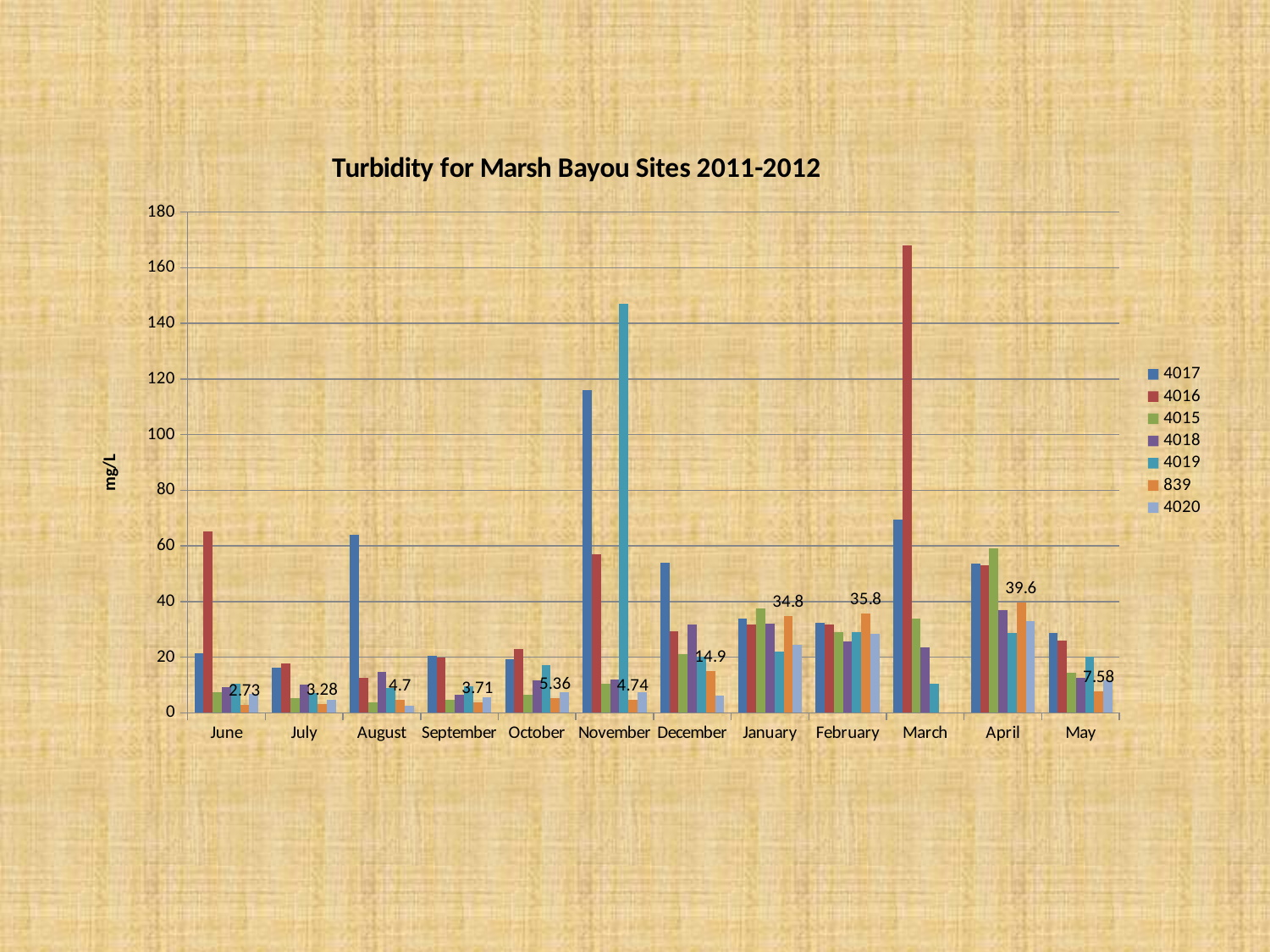
What is the value for site 839 in January? 34.8 In which month does site 4016 reach its highest value? March Which site has the highest value in November? 4019 What is the value for site 839 in June? 2.73 Is the value for site 4016 in March greater or less than 160? greater What is the value for site 839 in April? 39.6 How many sites are listed in the legend? 7 What is the difference between the site 839 values in April and January? 4.8 What is the value for site 839 in December? 14.9 How many months are shown on the x axis? 12 Is the value for site 4017 in November greater or less than 100? greater Which is larger for site 839: the January value or the February value? February